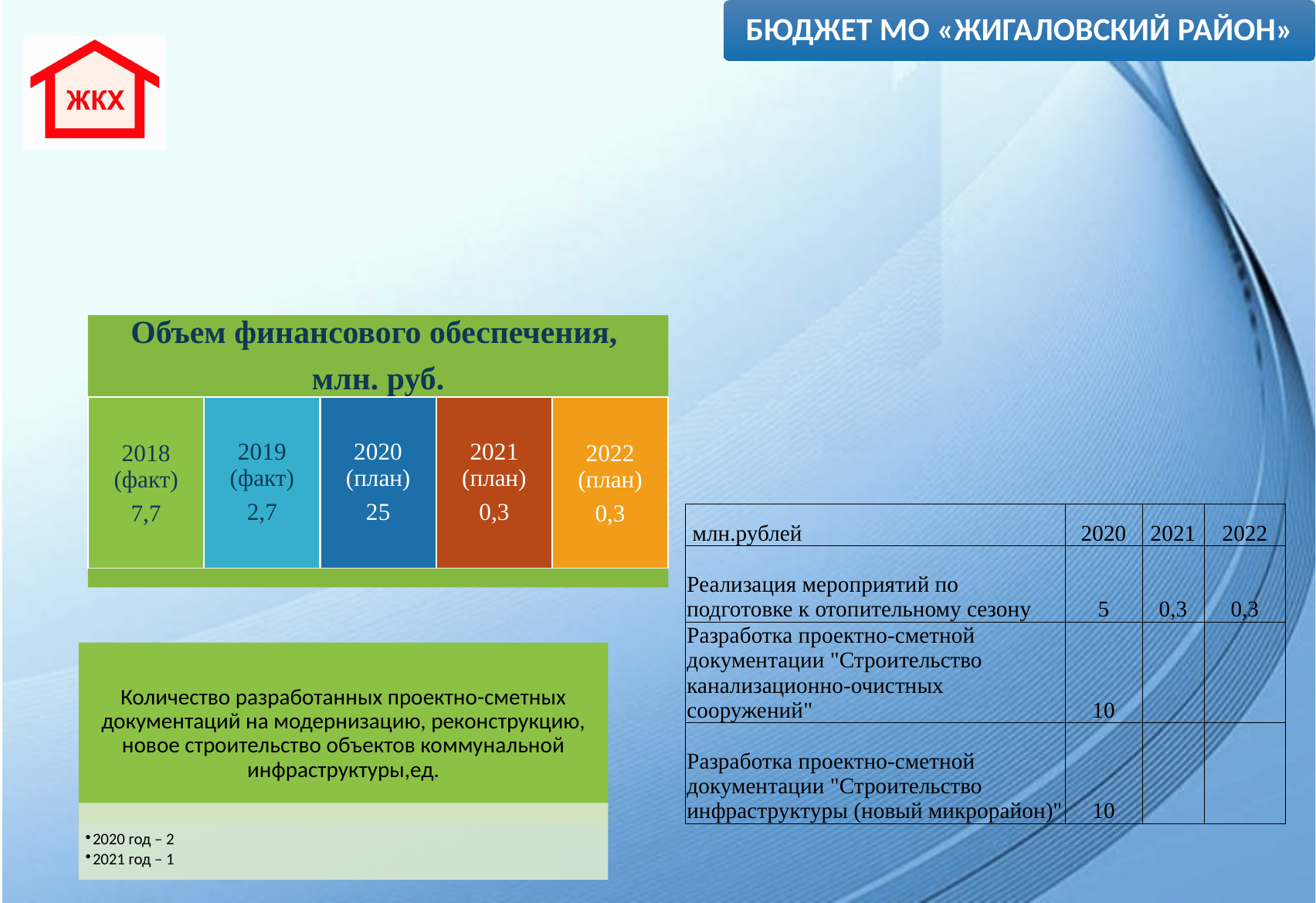
In the graphic titled «Объем финансового обеспечения, млн. руб.», what is the value for 2020 (план)? 25 In the graphic titled «Объем финансового обеспечения, млн. руб.», what is the value for 2022 (план)? 0,3 In the graphic titled «Объем финансового обеспечения, млн. руб.», do the values rise or fall from 2020 (план) to 2021 (план)? fall In the graphic titled «Объем финансового обеспечения, млн. руб.», what colour is the block for 2020 (план)? dark blue In the graphic titled «Объем финансового обеспечения, млн. руб.», what is the difference between the values for 2020 (план) and 2018 (факт)? 17,3 In the graphic titled «Объем финансового обеспечения, млн. руб.», what is the value for 2018 (факт)? 7,7 In the graphic titled «Объем финансового обеспечения, млн. руб.», how many years are shown? 5 In the graphic titled «Объем финансового обеспечения, млн. руб.», what is the total of all five values? 36 In the graphic titled «Объем финансового обеспечения, млн. руб.», what is the value for 2019 (факт)? 2,7 In the graphic titled «Объем финансового обеспечения, млн. руб.», which is larger: the value for 2019 (факт) or for 2021 (план)? 2019 (факт) In the graphic titled «Объем финансового обеспечения, млн. руб.», what is the difference between the values for 2018 (факт) and 2019 (факт)? 5 In the graphic titled «Объем финансового обеспечения, млн. руб.», which year has the highest value? 2020 (план)